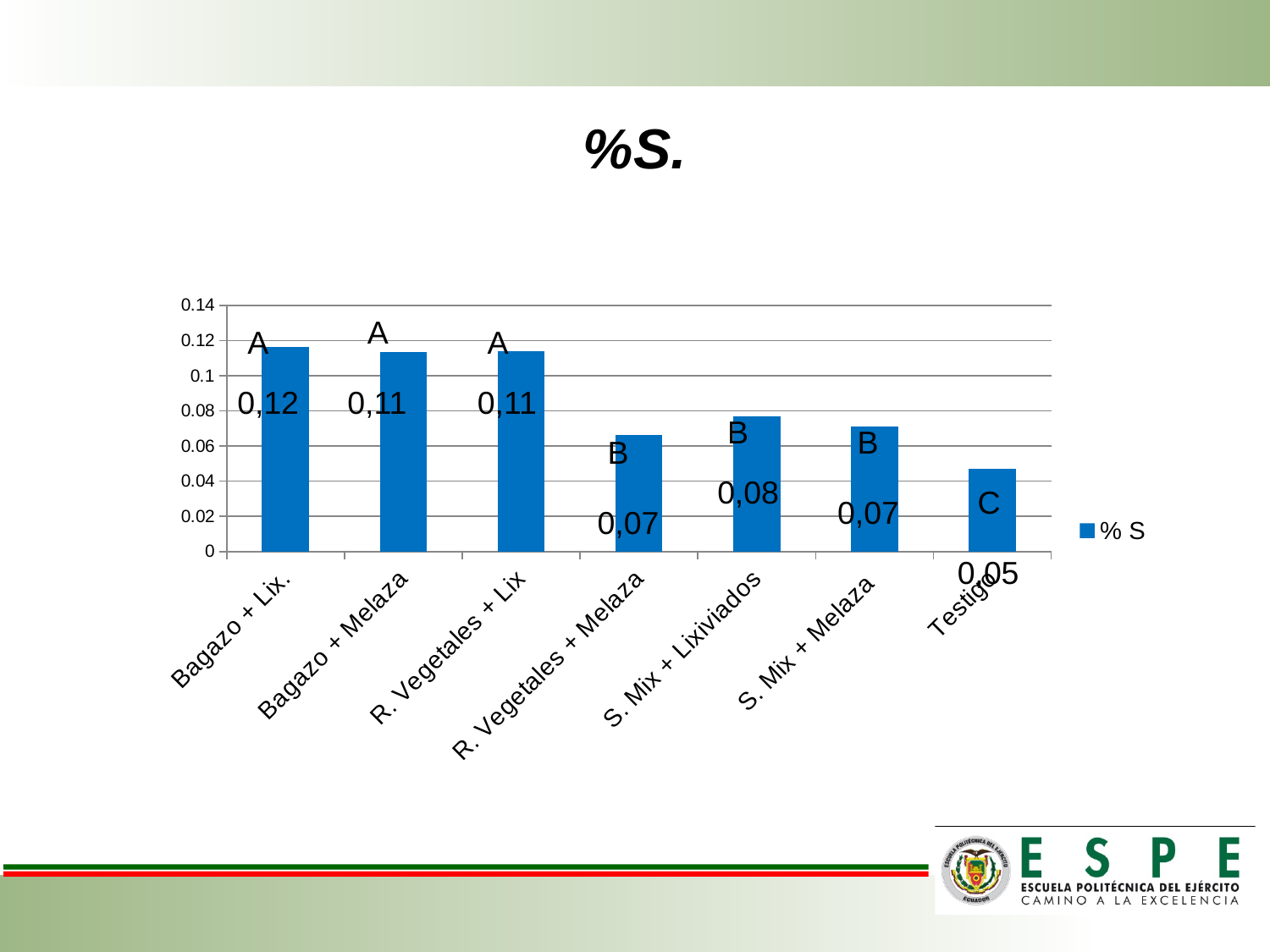
Is the value for Testigo greater or less than 0.06? less What is the title of the chart? %S. What is the difference between the values for Bagazo + Lix. and Testigo? 0,07 What is the value for Testigo? 0,05 What is the value for R. Vegetales + Melaza? 0,07 What is the value for Bagazo + Lix.? 0,12 Which category has the lowest value? Testigo What is the value for S. Mix + Lixiviados? 0,08 Which category has the highest value? Bagazo + Lix. Which is larger, the value for S. Mix + Lixiviados or the value for R. Vegetales + Melaza? S. Mix + Lixiviados How many categories are shown on the x axis? 7 What type of chart is shown on the slide? Bar chart